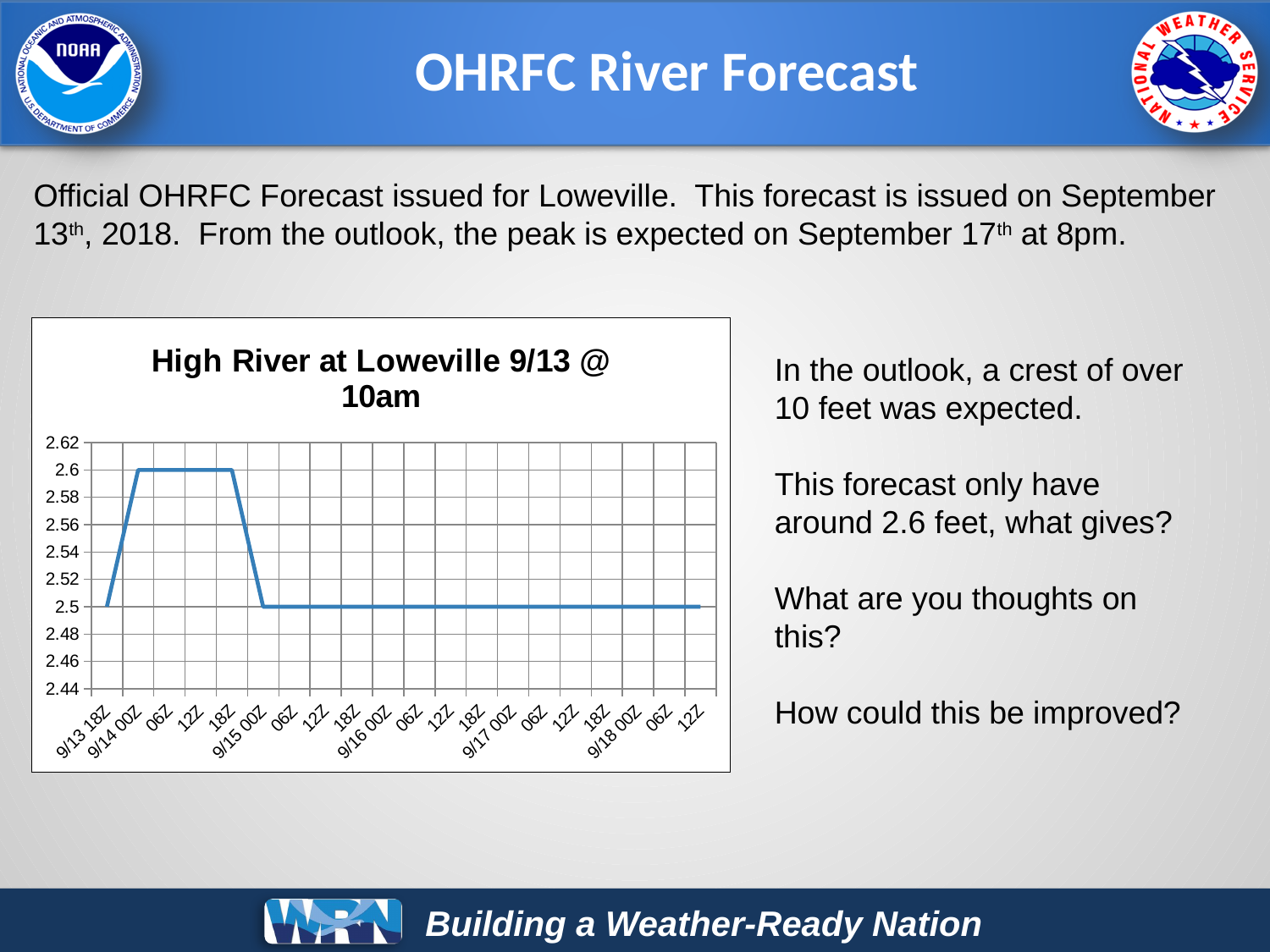
What is the value at 9/14 06Z? 2.6 What is the highest value reached by the line? 2.6 What is the difference between the value at 9/14 12Z and the value at 9/15 06Z? 0.1 How many time labels are shown on the x axis? 20 What is the lowest value reached by the line? 2.5 What is the title of the chart? High River at Loweville 9/13 @ 10am What is the value at 9/16 00Z? 2.5 How does the line behave from 9/15 00Z to 9/18 12Z? stays flat at 2.5 Is the value at 9/14 12Z greater or less than 2.56? greater Which is larger, the value at 9/14 18Z or the value at 9/17 00Z? 9/14 18Z What kind of chart is shown on the slide? line chart What is the value at 9/13 18Z? 2.5